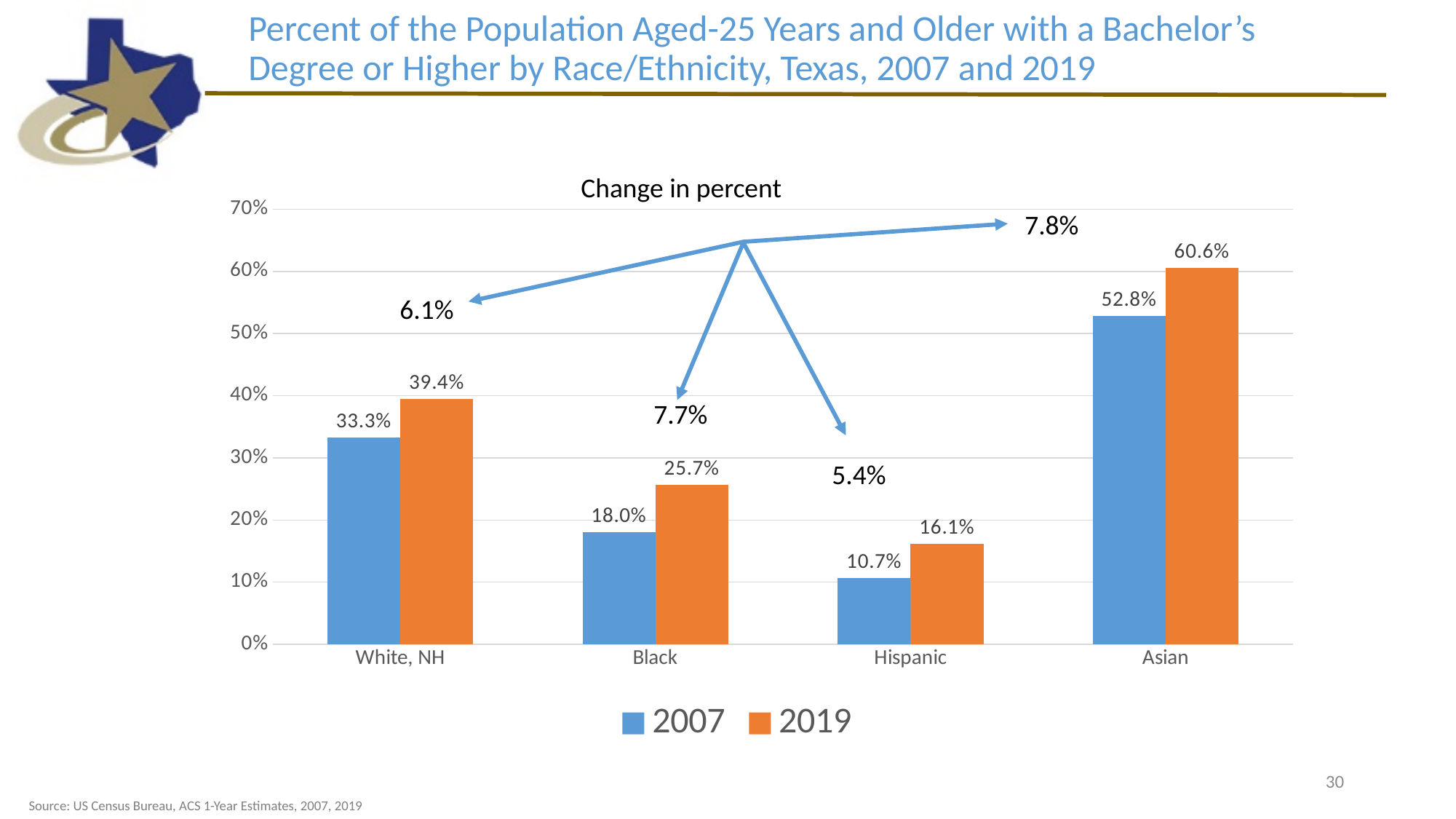
Is the 2007 value for Asian greater or less than 50%? greater How many race/ethnicity categories are shown on the x axis? 4 Which race/ethnicity group had the highest percent with a bachelor's degree or higher in 2019? Asian What is the difference between the 2019 and 2007 values for White, NH? 6.1% Which group had the largest change in percent between 2007 and 2019, according to the annotations? Asian Which is larger: the 2019 value for Black or the 2007 value for White, NH? 2007 value for White, NH What was the percent of the population aged 25 and older with a bachelor's degree or higher for Hispanic Texans in 2007? 10.7% Which race/ethnicity group had the lowest percent with a bachelor's degree or higher in 2007? Hispanic How many series does the legend list? 2 What was the 2019 value for Black Texans? 25.7% What was the 2019 value for Asian Texans? 60.6% What kind of chart is shown on the slide? Bar chart